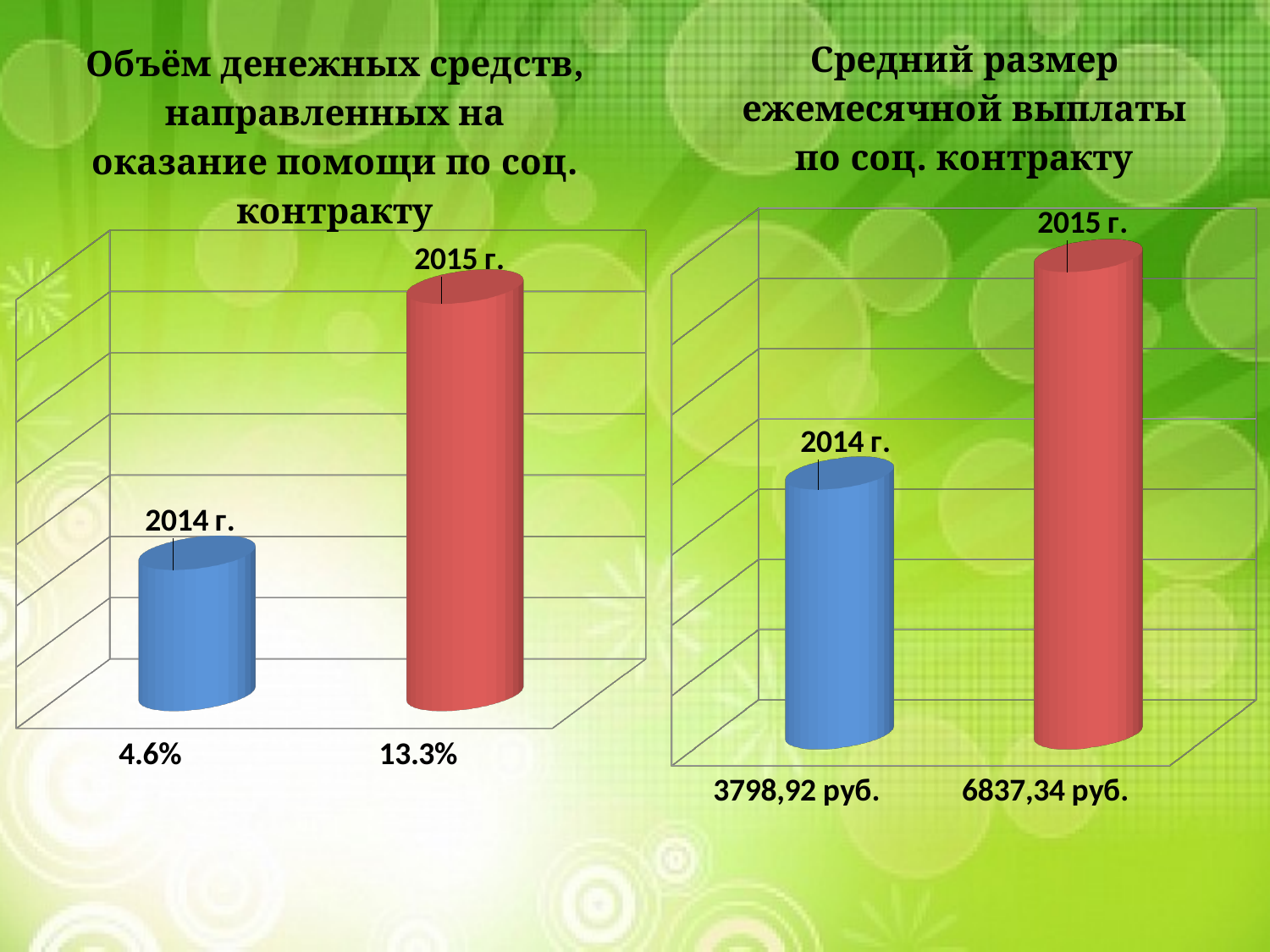
In the right chart (Средний размер ежемесячной выплаты по соц. контракту), what is the value for 2014 г.? 3798,92 руб. In the left chart (Объём денежных средств), which year has the higher value? 2015 г. What type of chart is the right chart (Средний размер ежемесячной выплаты)? bar chart In the left chart (Объём денежных средств, направленных на оказание помощи по соц. контракту), what is the value for 2015 г.? 13.3% In the right chart (Средний размер ежемесячной выплаты), is the value for 2015 г. larger or smaller than the value for 2014 г.? larger In the left chart (Объём денежных средств), do the values rise or fall from 2014 г. to 2015 г.? rise How many bars are shown in the left chart (Объём денежных средств)? 2 In the right chart (Средний размер ежемесячной выплаты), which year has the lower value? 2014 г. In the right chart (Средний размер ежемесячной выплаты по соц. контракту), what is the value for 2015 г.? 6837,34 руб. In the left chart (Объём денежных средств), what is the difference between the 2015 г. and 2014 г. values? 8.7% In the left chart (Объём денежных средств, направленных на оказание помощи по соц. контракту), what is the value for 2014 г.? 4.6% In the right chart (Средний размер ежемесячной выплаты), what is the difference between the 2015 г. and 2014 г. values? 3038,42 руб.